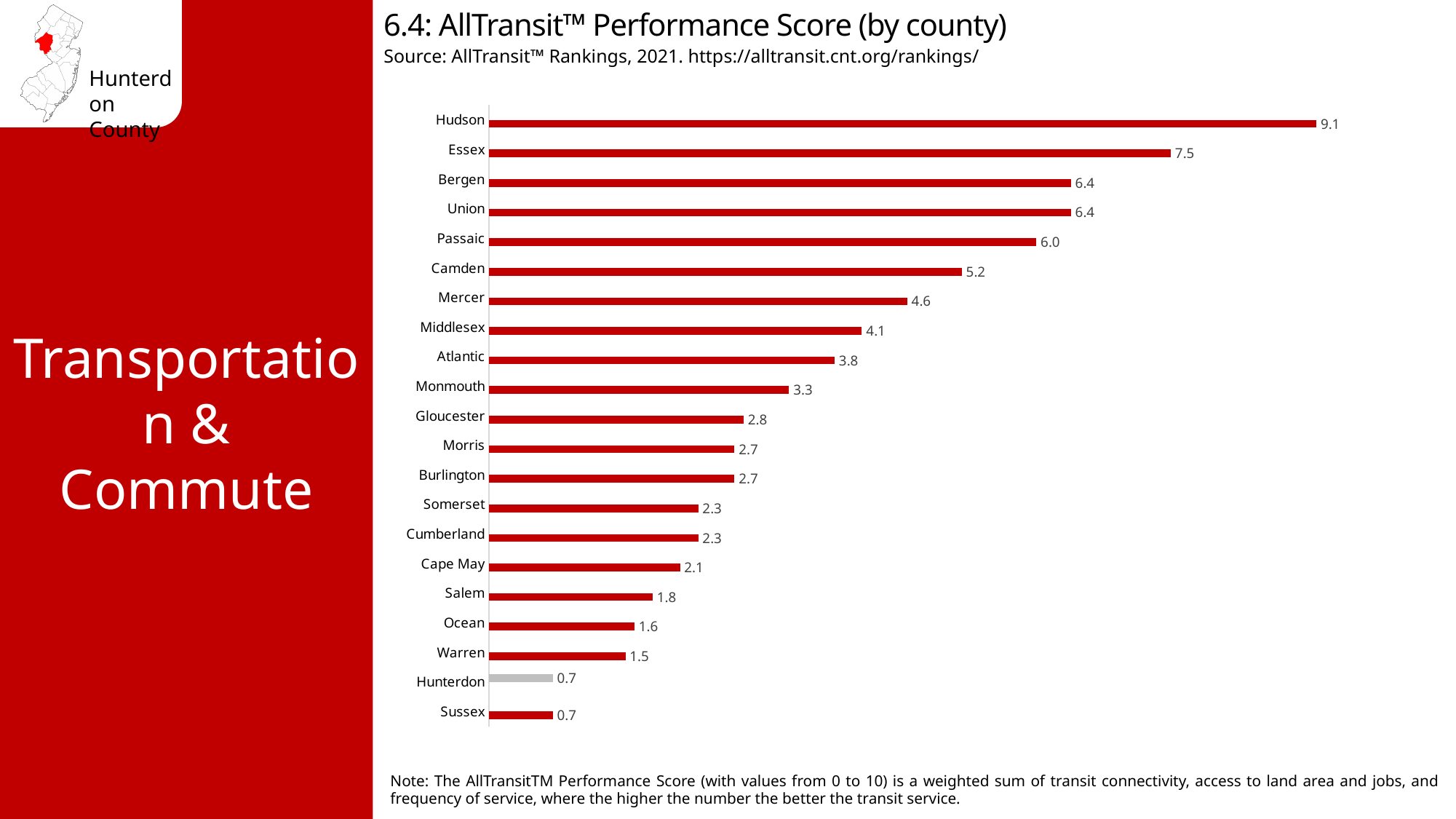
What is the AllTransit Performance Score for Hudson County? 9.1 What is the source of the data shown in the chart? AllTransit Rankings, 2021 What is the AllTransit Performance Score for Mercer County? 4.6 How many counties are shown in the chart? 21 Which county has a higher score, Salem or Cape May? Cape May Which county has a higher score, Camden or Middlesex? Camden What is the difference between the scores of Hudson and Essex counties? 1.6 Which county's bar is shown in grey rather than red? Hunterdon What is the difference between the scores of Warren and Hunterdon counties? 0.8 What is the AllTransit Performance Score for Hunterdon County? 0.7 What type of chart is used to show the AllTransit Performance Scores? Bar chart Which county has the highest AllTransit Performance Score? Hudson